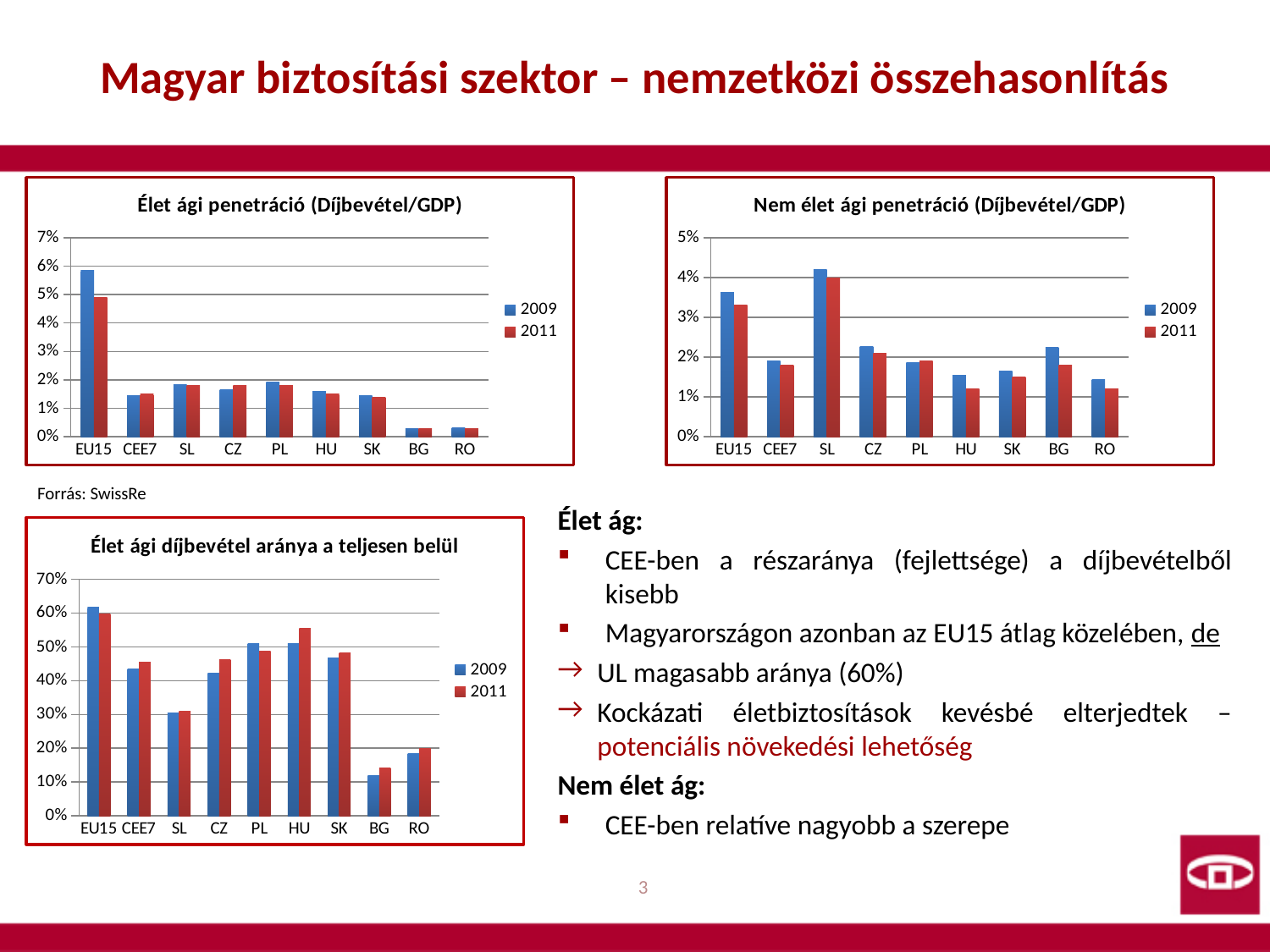
In the chart titled 'Élet ági penetráció (Díjbevétel/GDP)', is the 2009 value for EU15 greater or less than 5%? greater In the chart titled 'Élet ági penetráció (Díjbevétel/GDP)', which category has the highest value for 2009? EU15 In the chart titled 'Élet ági díjbevétel aránya a teljesen belül', is the 2011 value for HU greater or less than 50%? greater How many categories are shown on the x axis of the chart titled 'Élet ági penetráció (Díjbevétel/GDP)'? 9 How many series does the legend list in the chart titled 'Nem élet ági penetráció (Díjbevétel/GDP)'? 2 In the chart titled 'Élet ági díjbevétel aránya a teljesen belül', which category has the lowest value for 2009? BG In the chart titled 'Élet ági penetráció (Díjbevétel/GDP)', is the 2011 value for BG greater or less than 1%? less In the chart titled 'Élet ági díjbevétel aránya a teljesen belül', which is larger for 2011: HU or PL? HU What type of chart is the chart titled 'Élet ági díjbevétel aránya a teljesen belül'? bar chart In the chart titled 'Nem élet ági penetráció (Díjbevétel/GDP)', which is larger for 2009: EU15 or SL? SL In the chart titled 'Nem élet ági penetráció (Díjbevétel/GDP)', which category has the highest value for 2009? SL